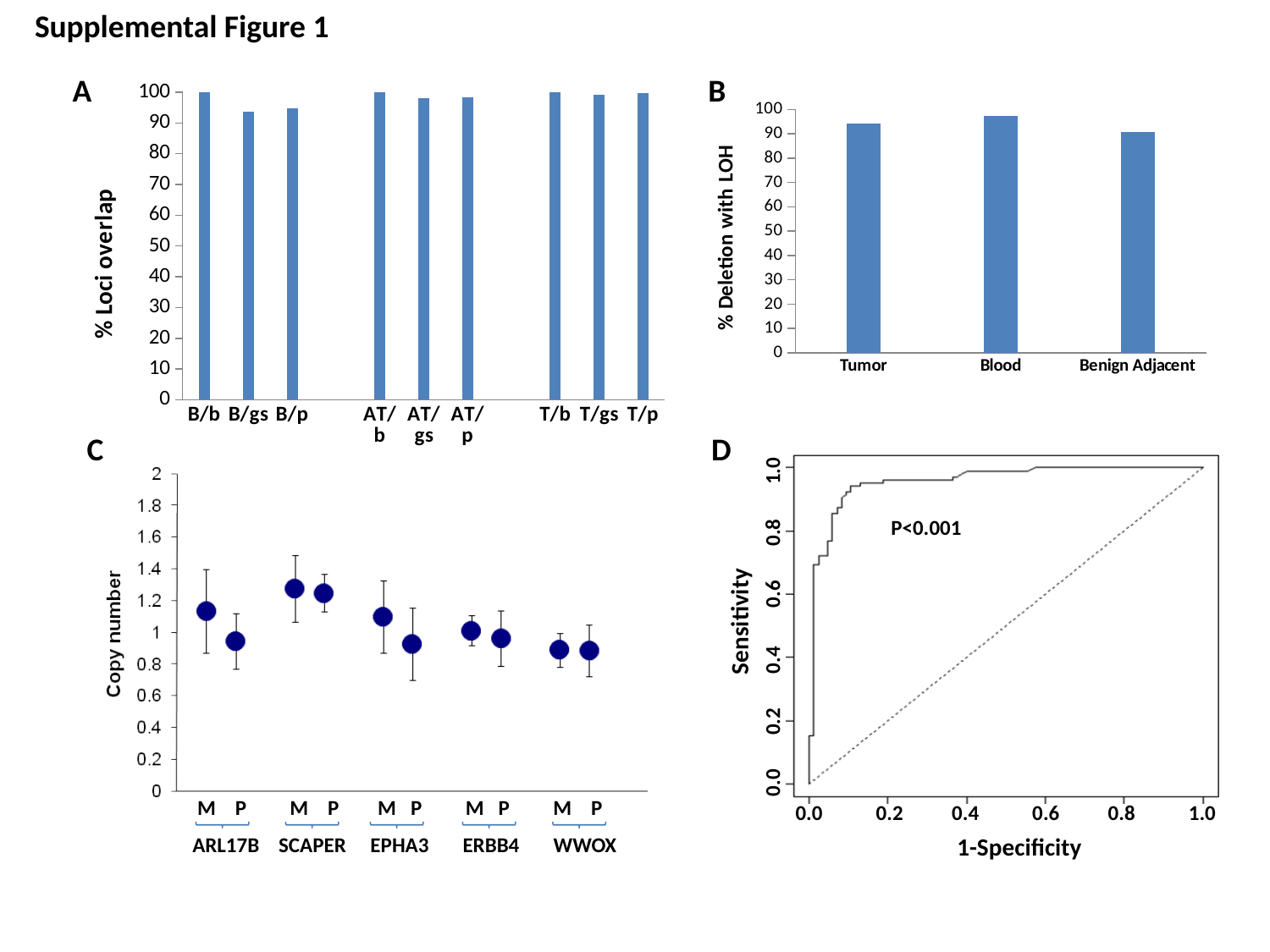
In panel C, how many genes are labelled on the x axis? 5 In panel A, what is the % Loci overlap for B/b? 100 In panel D, what is the label of the x axis? 1-Specificity In panel C, for ARL17B, which has the higher copy number, M or P? M In panel C, is the copy number for SCAPER M greater or less than 1.2? greater In panel B, which category has the lowest % Deletion with LOH? Benign Adjacent In panel A, what is the % Loci overlap for T/b? 100 In panel B, is the value for Benign Adjacent greater or less than 80? greater What kind of chart is panel B? bar chart In panel B, how many categories are shown on the x axis? 3 In panel B, which category has the highest % Deletion with LOH? Blood In panel A, how many bars are plotted? 9